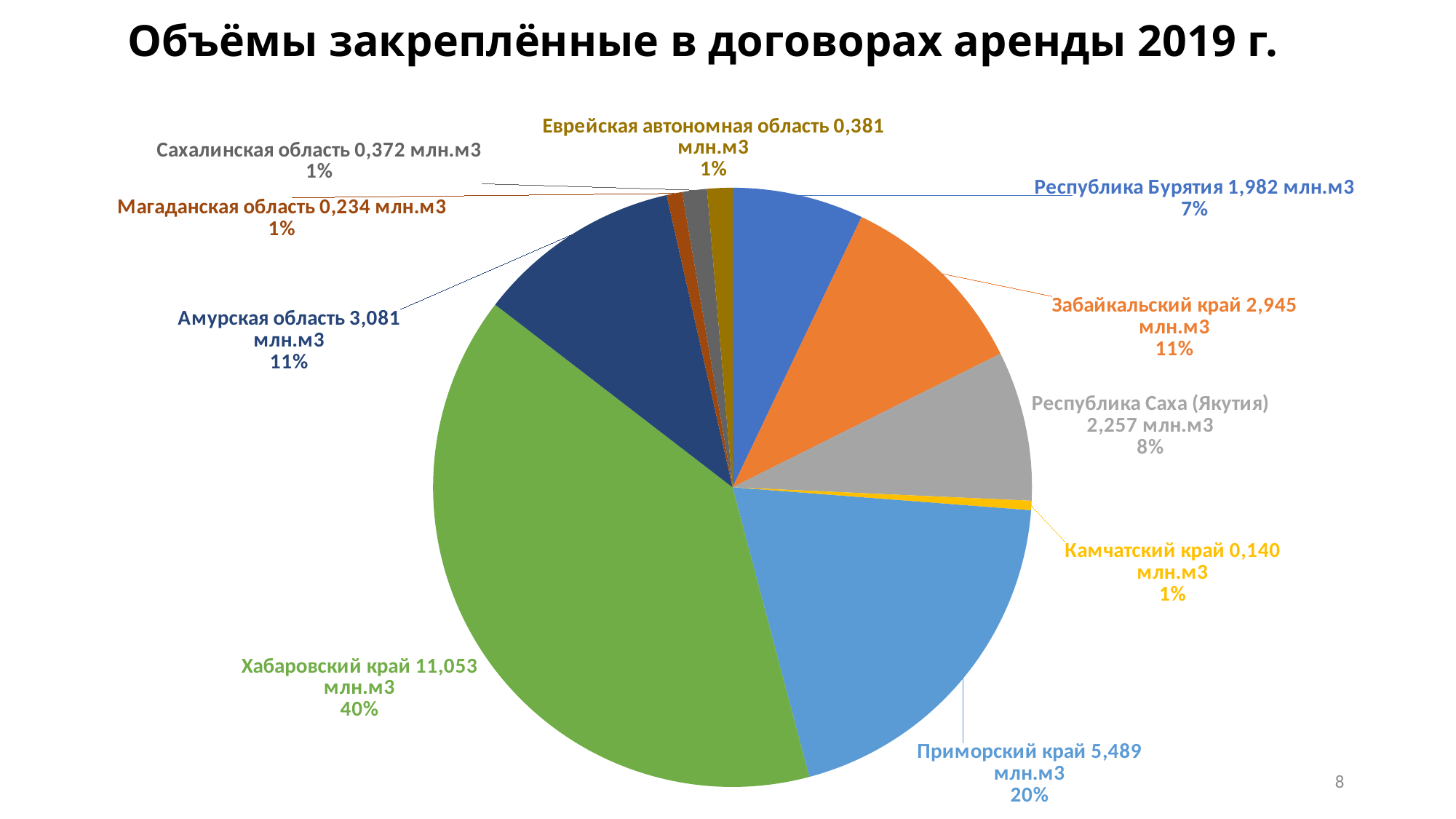
What volume is shown for Республика Саха (Якутия)? 2,257 млн.м3 What kind of chart is shown on the slide? pie chart Which is larger, the volume for Забайкальский край or for Республика Саха (Якутия)? Забайкальский край What volume is shown for Приморский край? 5,489 млн.м3 Which region has the smallest volume? Камчатский край What share of the pie does Республика Бурятия account for? 7% What is the title of the chart? Объёмы закреплённые в договорах аренды 2019 г. How many regions (slices) are shown in the pie chart? 10 Which region has the largest share of the pie? Хабаровский край What volume is shown for Хабаровский край? 11,053 млн.м3 What share of the pie does Приморский край account for? 20% What is the difference in volume between Хабаровский край and Приморский край? 5,564 млн.м3